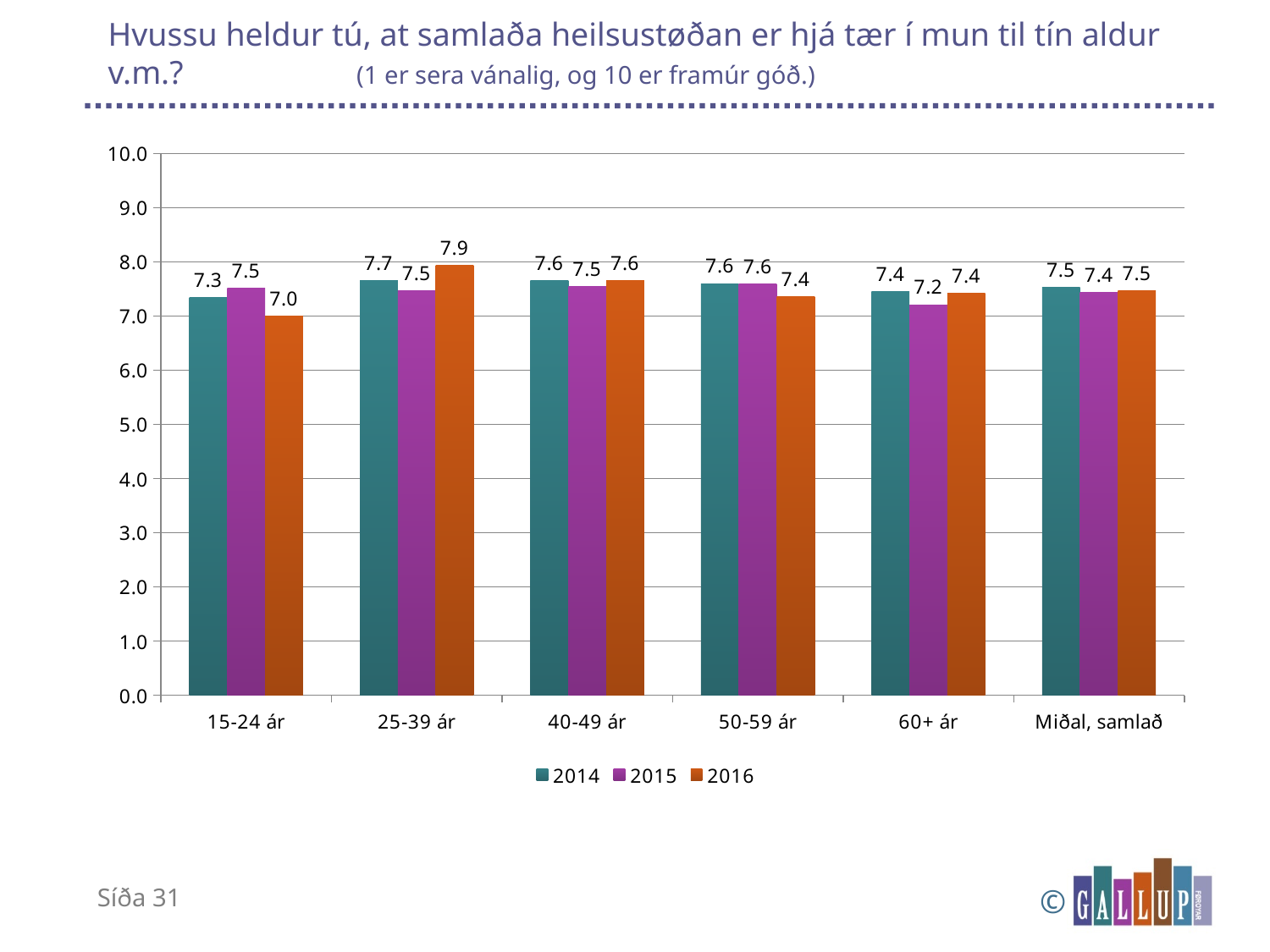
What is the value for 2015 in the Miðal, samlað category? 7.4 What is the value for 2014 in the 25-39 ár category? 7.7 Which age category has the lowest value for 2016? 15-24 ár What is the difference between the 2016 and 2014 values in the 25-39 ár category? 0.2 What is the value for 2015 in the 60+ ár category? 7.2 How many categories are shown on the x axis? 6 Which age category has the highest value for 2016? 25-39 ár Is the value for 2016 in the 25-39 ár category greater or less than 7.0? greater What kind of chart is shown on the slide? bar chart What is the value for 2016 in the 15-24 ár category? 7.0 How many series does the legend list? 3 In the 15-24 ár category, which is larger: the 2015 value or the 2016 value? 2015